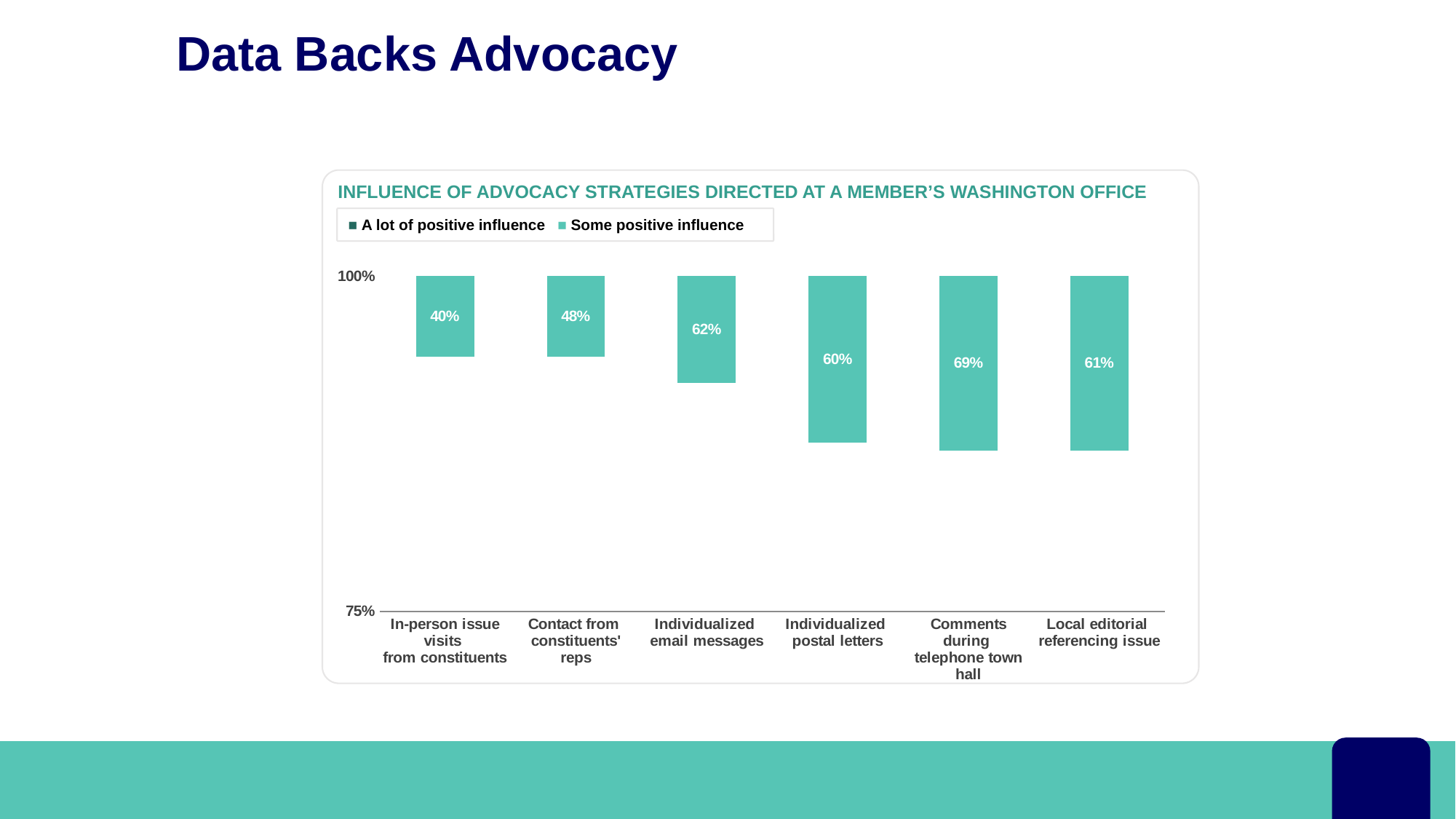
What is the 'Some positive influence' value for Comments during telephone town hall? 69% Which has a larger 'Some positive influence' value: Individualized email messages or Individualized postal letters? Individualized email messages What is the 'Some positive influence' value for Contact from constituents' reps? 48% What is the difference between the 'Some positive influence' values for Comments during telephone town hall and In-person issue visits from constituents? 29 percentage points How many series does the legend list? 2 What is the 'Some positive influence' value for Local editorial referencing issue? 61% Which advocacy strategy has the lowest labelled 'Some positive influence' value? In-person issue visits from constituents What kind of chart is shown on the slide? Bar chart What is the 'Some positive influence' value for Individualized email messages? 62% Which advocacy strategy has the highest labelled 'Some positive influence' value? Comments during telephone town hall How many advocacy strategies are shown on the x axis? 6 What is the 'Some positive influence' value for In-person issue visits from constituents? 40%